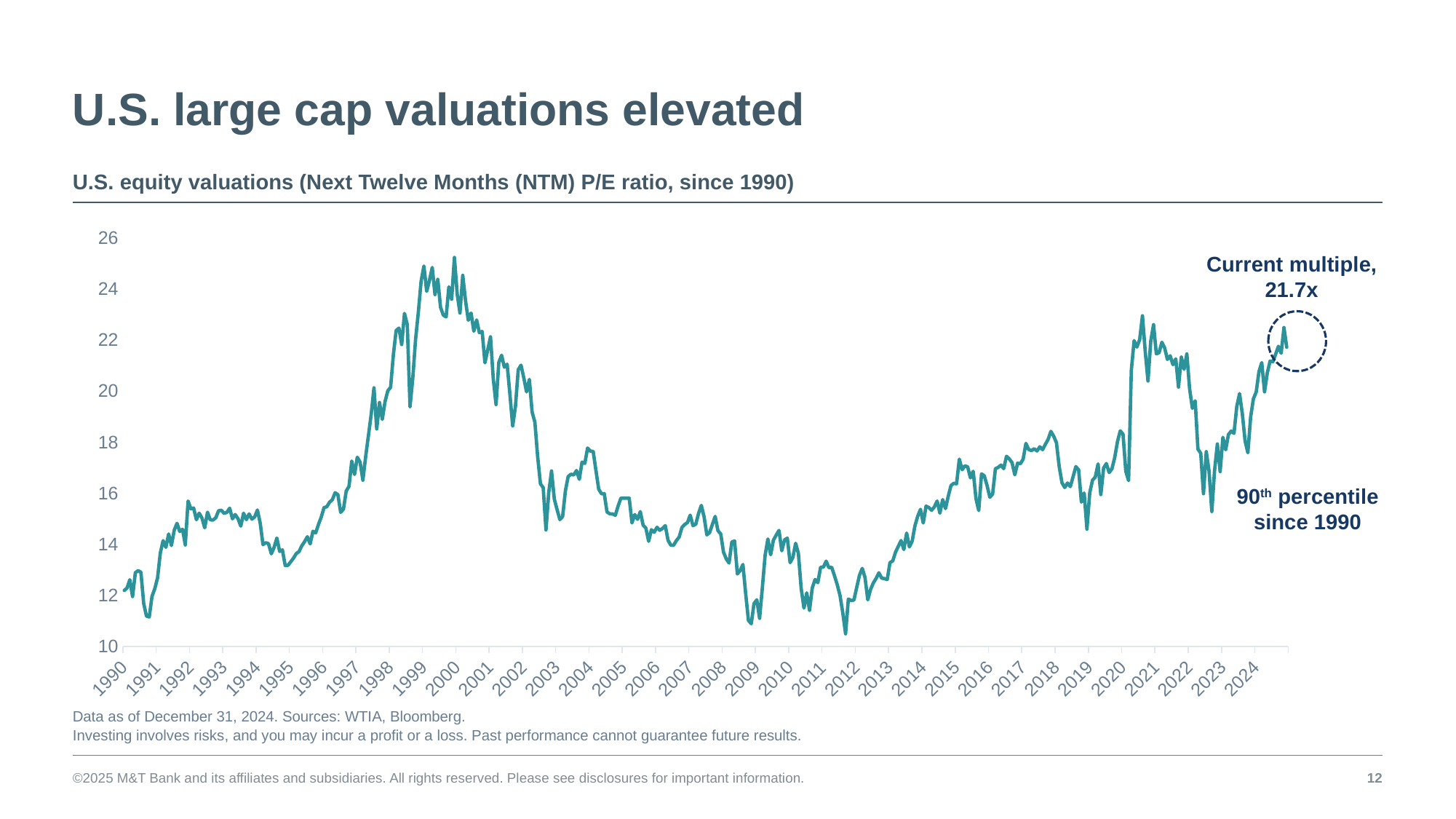
Is the lowest value in 2011 greater or less than 12? less As of what date is the chart data? December 31, 2024 Which peak is higher, the one around 2000 or the one around 2020? 2000 Is the value during 2017 greater or less than 16? greater What is the current NTM P/E multiple labelled on the chart? 21.7x In which year does the NTM P/E ratio reach its lowest point? 2011 Does the NTM P/E ratio generally rise or fall from 2012 to 2024? rise Is the value at the start of 1990 greater or less than 14? less According to the annotation, what percentile since 1990 is the current multiple at? 90th percentile What kind of chart is shown on the slide? line chart